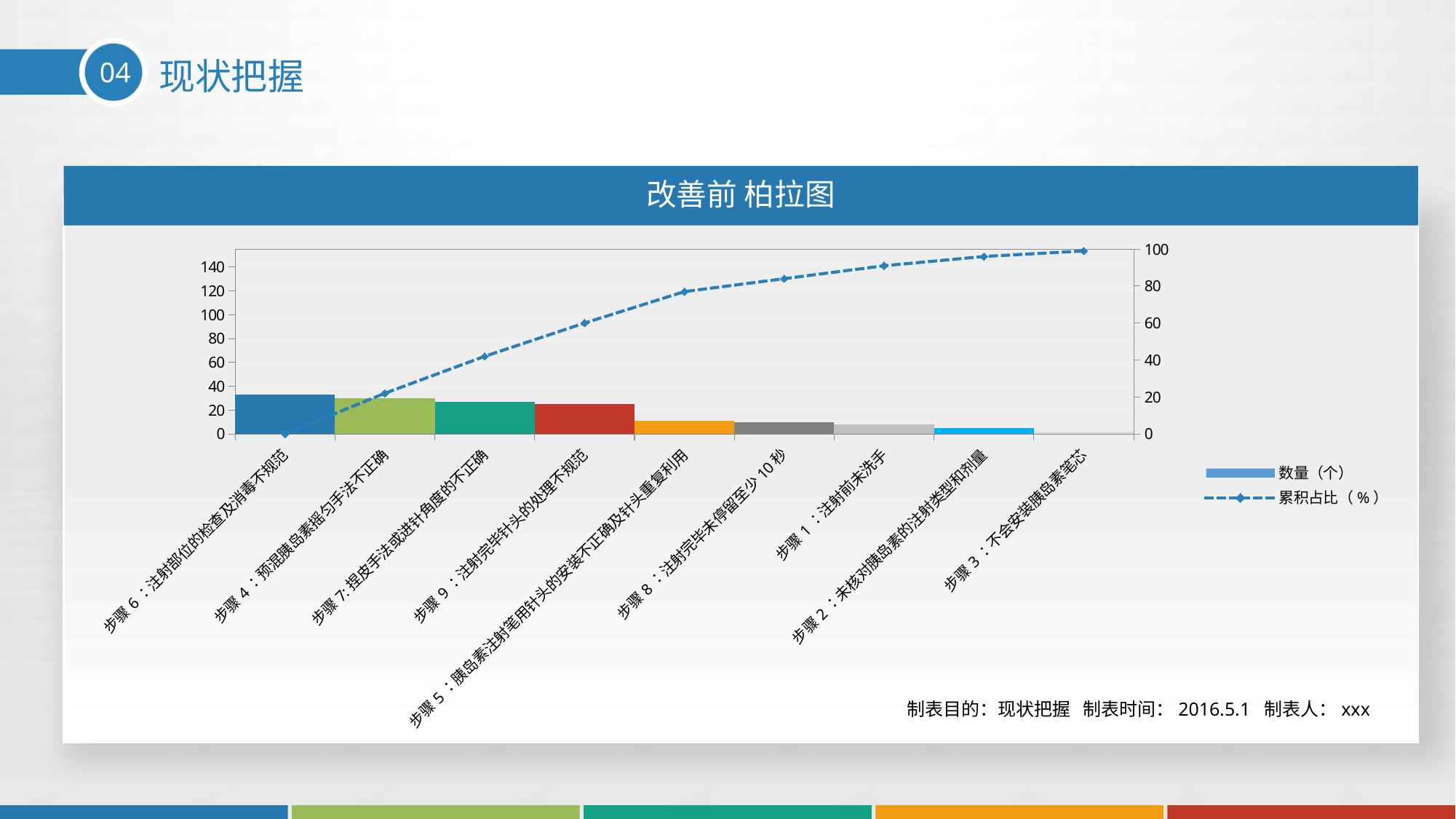
Is the 数量（个） value for 步骤 6：注射部位的检查及消毒不规范 greater or less than 20? greater What is the title of the chart on the slide? 改善前 柏拉图 Is the 数量（个） value for 步骤 2：未核对胰岛素的注射类型和剂量 greater or less than 20? less Is the 数量（个） value for 步骤 5：胰岛素注射笔用针头的安装不正确及针头重复利用 greater or less than 20? less Which category has the highest 数量（个） bar? 步骤 6：注射部位的检查及消毒不规范 What are the two series named in the legend? 数量（个） and 累积占比（%） Which has a larger 数量（个） value: 步骤 9：注射完毕针头的处理不规范 or 步骤 1：注射前未洗手? 步骤 9：注射完毕针头的处理不规范 What kind of chart is shown on the slide? Bar chart with a cumulative line (Pareto chart) How many series does the chart's legend list? 2 Do the 数量（个） bars rise or fall from left to right along the x axis? fall How many categories are shown on the x axis of the chart? 9